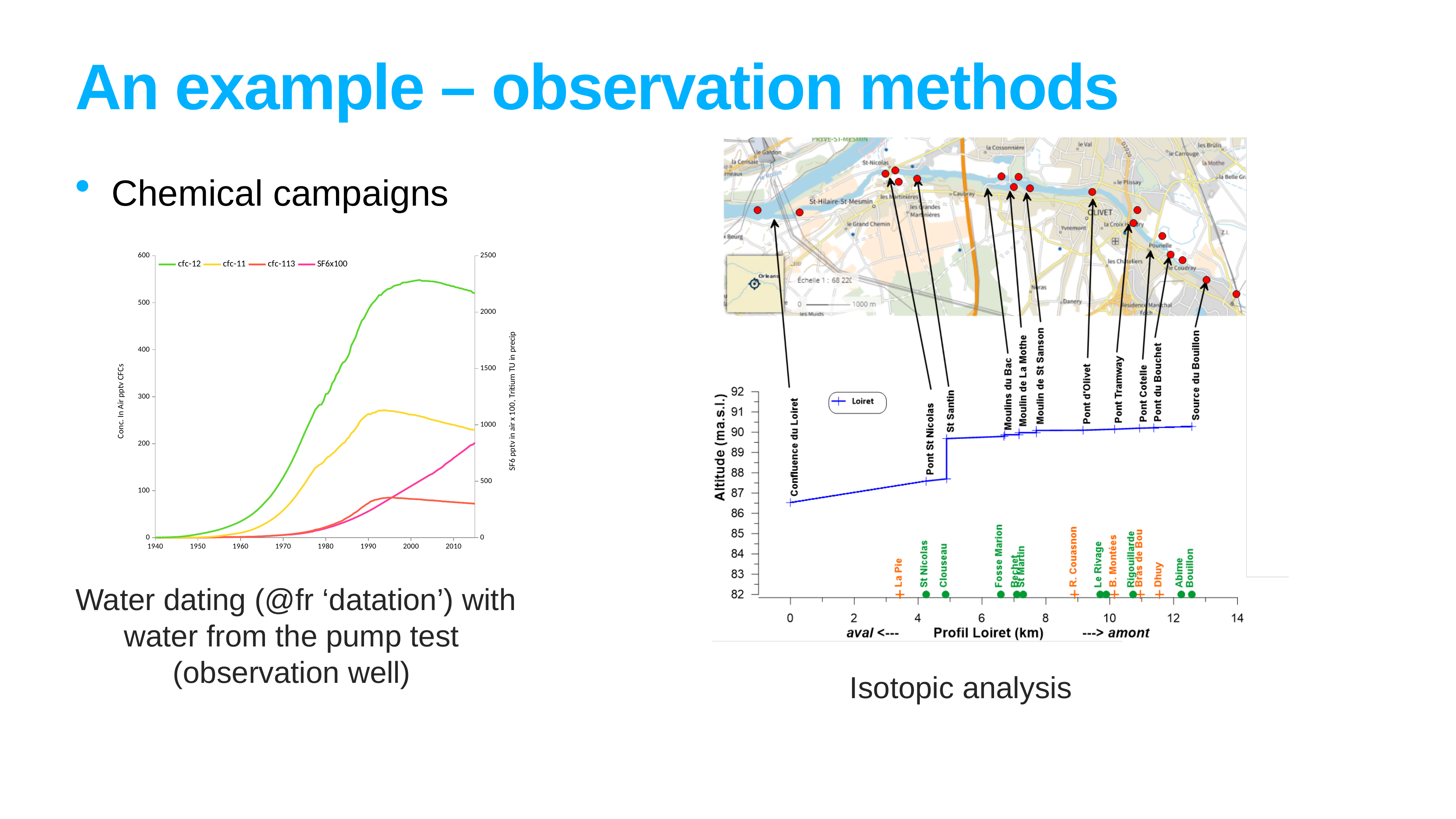
On the left chart (CFC concentrations), is the peak value of cfc-113 greater or less than 100? less On the left chart (CFC concentrations), does the SF6x100 series rise or fall from 1980 to 2010? rise On the right chart (Altitude vs Profil Loiret), is the altitude at Confluence du Loiret greater or less than 87? less On the right chart (Altitude vs Profil Loiret), what is the label of the x axis? Profil Loiret (km) On the left chart (CFC concentrations), how many series does the legend list? 4 On the right chart (Altitude vs Profil Loiret), how many series does the legend list? 1 On the left chart (CFC concentrations), what colour is the cfc-12 line? green On the right chart (Altitude vs Profil Loiret), does the altitude rise or fall from Confluence du Loiret to Source du Bouillon? rise On the left chart (CFC concentrations), what kind of chart is it? line chart On the left chart (CFC concentrations), which is larger in 1990: cfc-11 or cfc-113? cfc-11 On the left chart (CFC concentrations), is the value of cfc-12 in 2000 greater or less than 500? greater